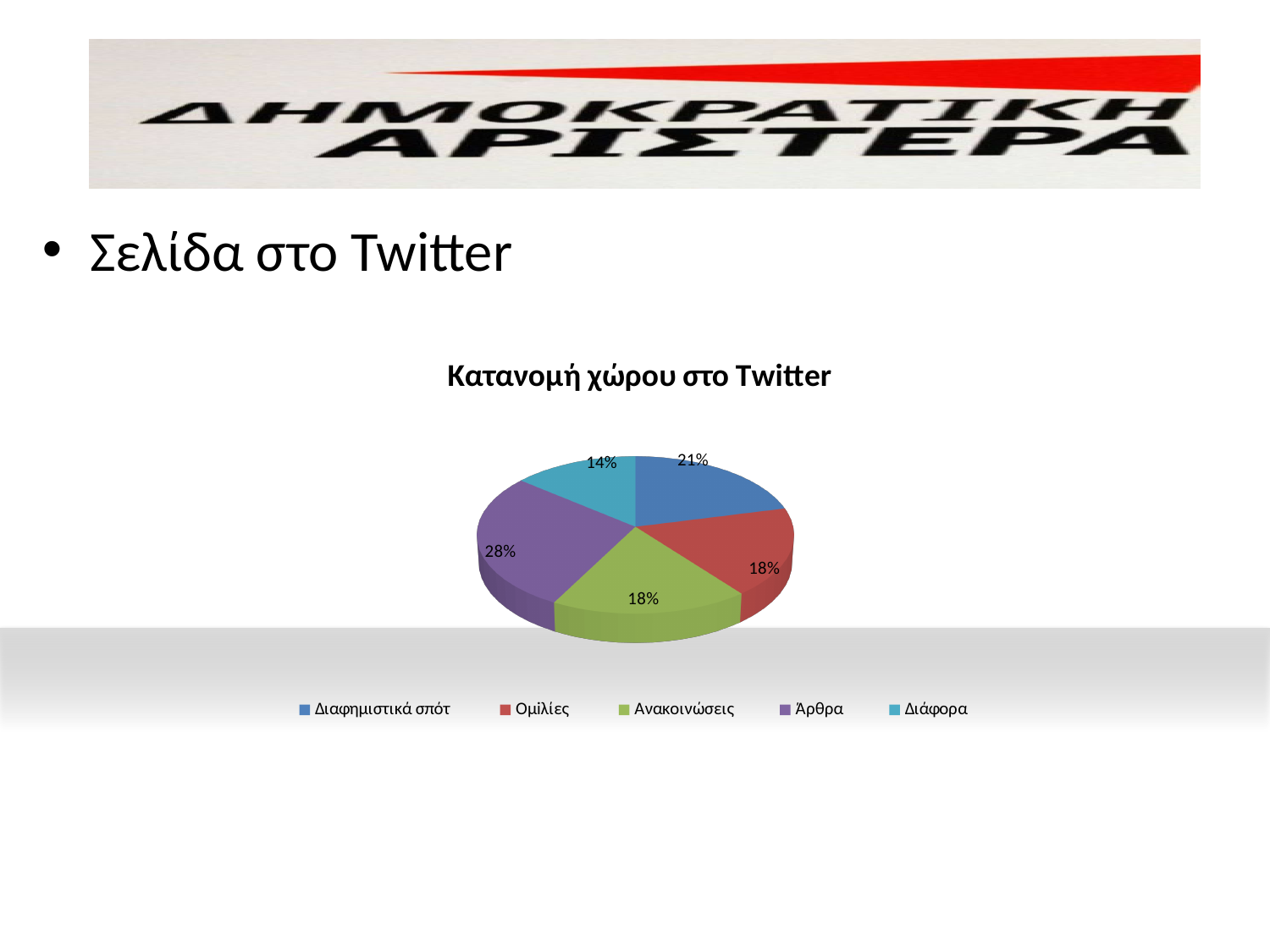
Which category is shown in purple in the legend? Άρθρα Which category has the largest slice of the pie? Άρθρα Which category has the smallest slice of the pie? Διάφορα What kind of chart is shown on the slide? Pie chart What is the value shown for Διάφορα? 14% Which is larger, the share for Διαφημιστικά σπότ or the share for Ανακοινώσεις? Διαφημιστικά σπότ What is the title of the chart? Κατανομή χώρου στο Twitter What share of the pie does Άρθρα have? 28% What is the value shown for Ομιλίες? 18% How many categories does the pie chart show? 5 What is the value shown for Διαφημιστικά σπότ? 21% What is the difference between the shares of Άρθρα and Διάφορα? 14%